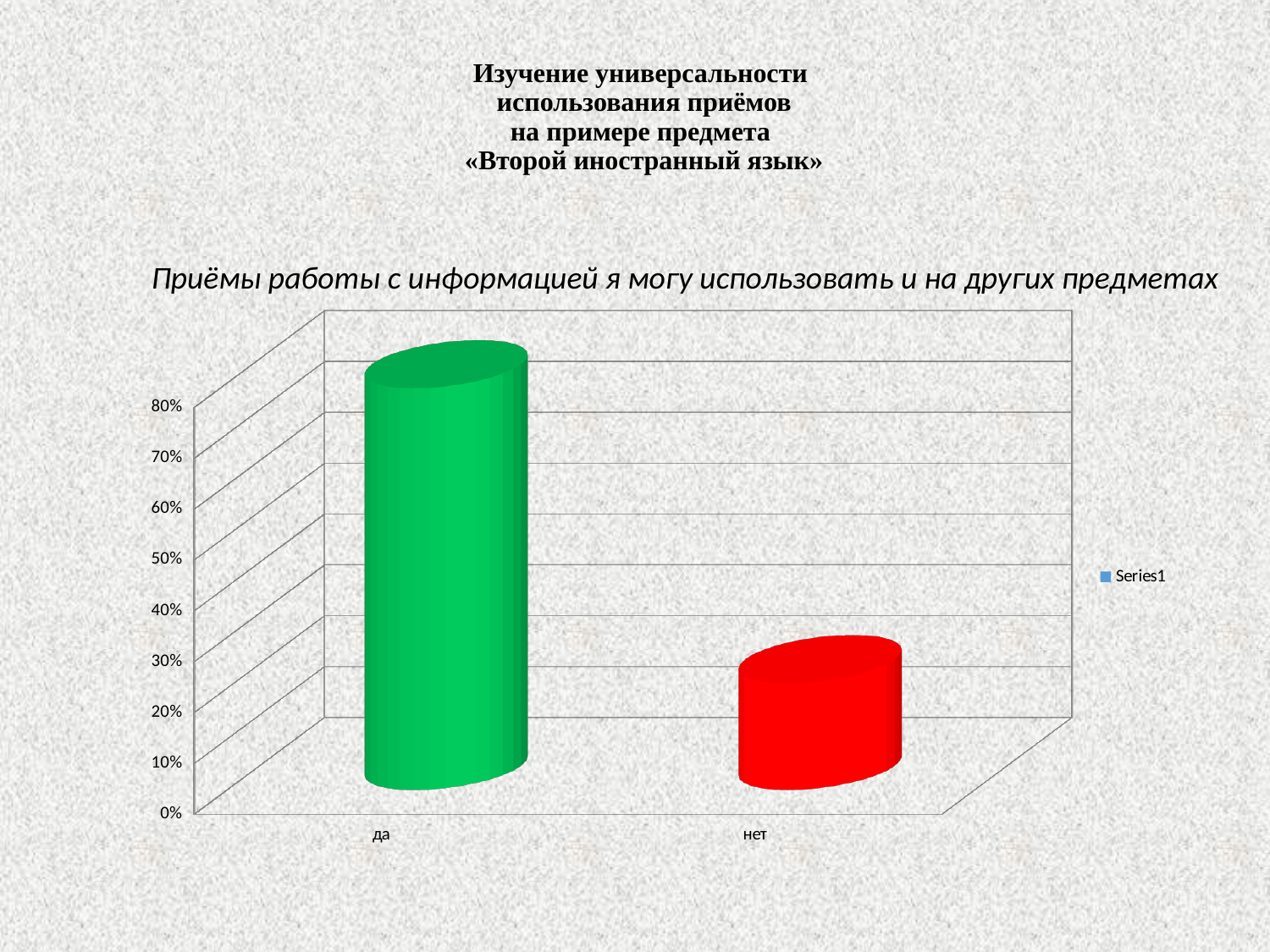
Is the value for "нет" greater or less than 50%? less How many series does the chart legend list? 1 What is the title of the chart? Приёмы работы с информацией я могу использовать и на других предметах Which category has the highest value in the chart? да Is the value for "да" greater or less than 60%? greater Which category has the lowest value in the chart? нет Is the value for "нет" greater or less than 40%? less Which is larger, the value for "да" or the value for "нет"? да What kind of chart is shown on the slide? bar chart What colour is the bar for "нет"? red How many categories are shown on the x axis of the chart? 2